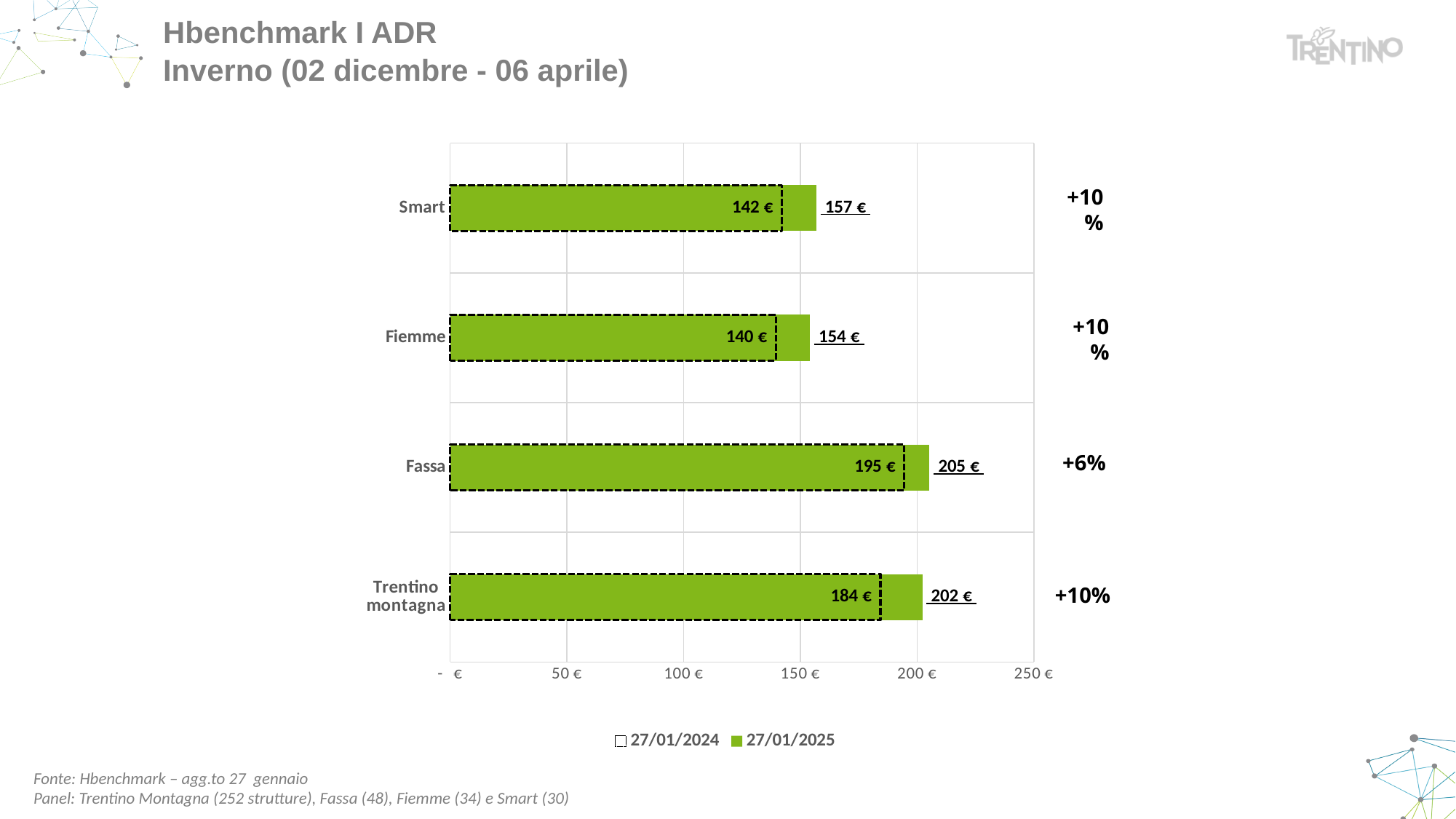
Which category has the highest ADR value on 27/01/2025? Fassa What is the ADR value for Fiemme on 27/01/2024? 140 € What kind of chart is shown on the slide? Bar chart Which is larger: the 27/01/2025 value for Fassa or the 27/01/2025 value for Trentino montagna? Fassa How many series does the legend list? 2 What is the ADR value for Smart on 27/01/2025? 157 € What is the difference between the 27/01/2025 and 27/01/2024 ADR values for Trentino montagna? 18 € What is the ADR value for Trentino montagna on 27/01/2024? 184 € Which category has the lowest ADR value on 27/01/2024? Fiemme How many categories are shown on the chart? 4 What percentage change is shown next to the Fassa bars? +6% What is the ADR value for Fassa on 27/01/2025? 205 €